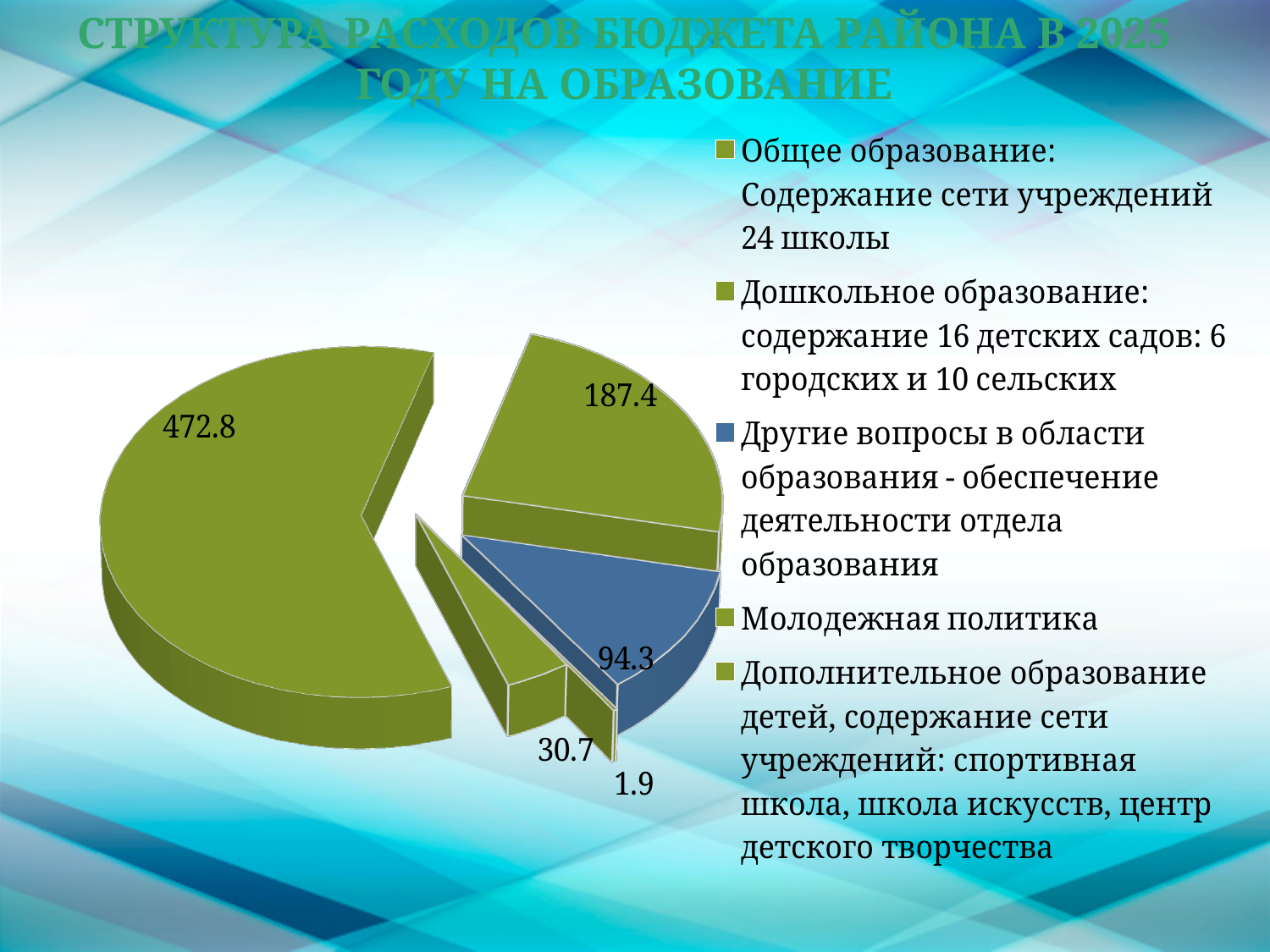
How many slices does the pie chart have? 5 What is the value for Дошкольное образование? 187.4 What type of chart is shown on the slide? Pie chart Which slice is shown in blue? Другие вопросы в области образования How many entries does the legend list? 5 What is the value for Дополнительное образование детей? 30.7 What is the value for Общее образование (Содержание сети учреждений 24 школы)? 472.8 What is the difference between the values for Общее образование and Дошкольное образование? 285.4 Which category has the largest slice? Общее образование What is the value for Другие вопросы в области образования (the blue slice)? 94.3 What is the value for Молодежная политика? 1.9 Which category has the smallest slice? Молодежная политика